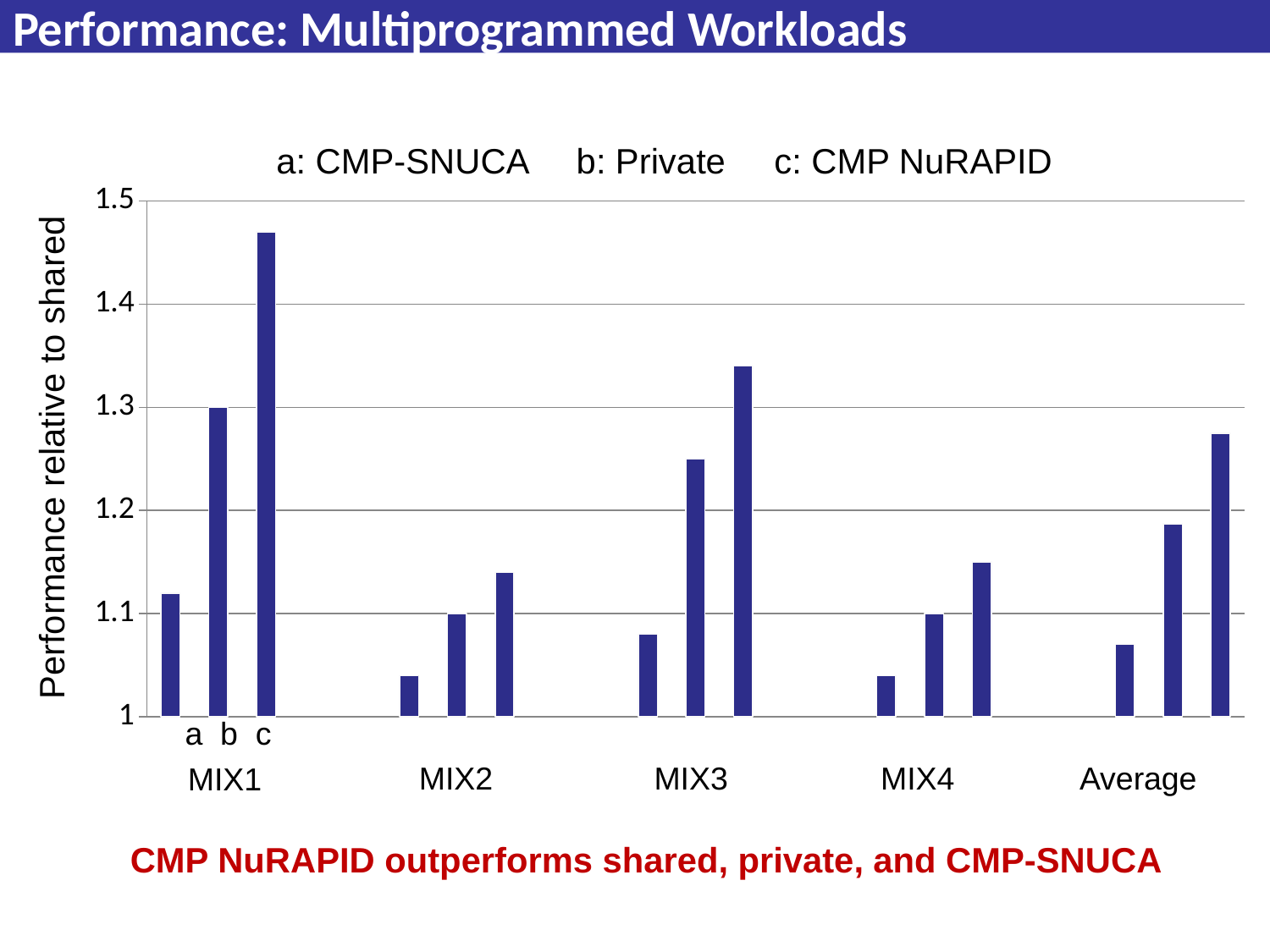
Within MIX1, which configuration has the tallest bar? c: CMP NuRAPID Which is larger: the Private (b) value for MIX1 or the Private (b) value for MIX3? MIX1 Is the CMP-SNUCA (a) value for MIX2 greater or less than 1.1? less What kind of chart is shown on the slide? bar chart Which category has the highest CMP NuRAPID (c) bar? MIX1 Which category has the highest Private (b) bar? MIX1 Is the CMP NuRAPID (c) value for Average greater or less than 1.2? greater How many workload categories are shown along the x axis? 5 Is the CMP NuRAPID (c) value for MIX1 greater or less than 1.4? greater How many configurations (series) does the legend list? 3 What is the label of the y axis? Performance relative to shared